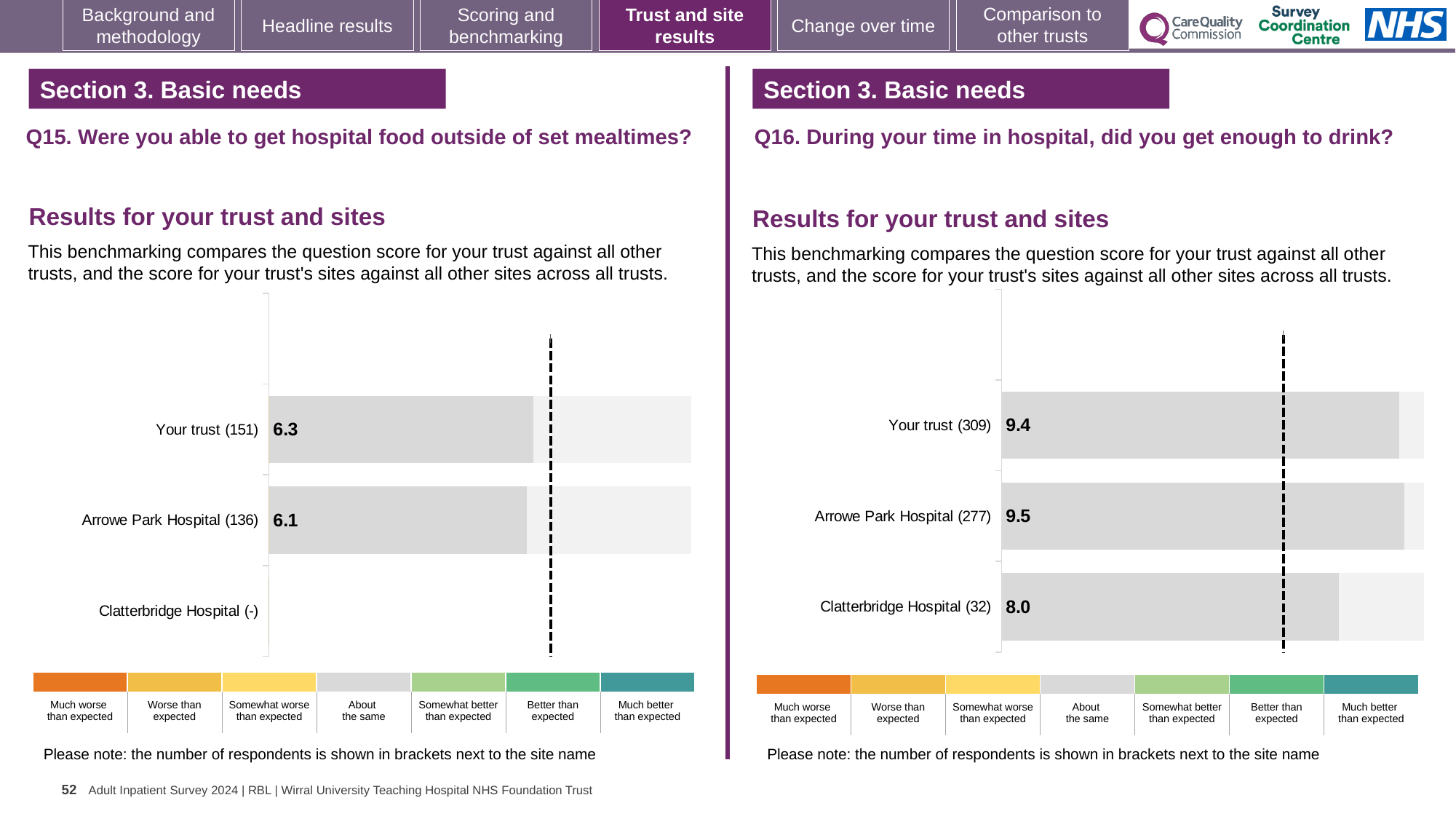
How many categories (trust and sites) are listed on the Q16 chart on the right? 3 In the Q15 chart on the left, what is the score for Your trust? 6.3 In the Q16 chart on the right, what is the score for Your trust? 9.4 In the Q15 chart on the left, how many respondents are shown in brackets for Arrowe Park Hospital? 136 In the Q15 chart on the left, what is the score for Arrowe Park Hospital? 6.1 What kind of chart is used for the Q15 results on the left? Bar chart In the Q16 chart on the right, what is the score for Clatterbridge Hospital? 8.0 In the Q15 chart on the left, which has the higher score, Your trust or Arrowe Park Hospital? Your trust In the Q15 chart on the left, what is the difference between the scores for Your trust and Arrowe Park Hospital? 0.2 In the Q16 chart on the right, which site or trust has the highest score? Arrowe Park Hospital In the Q16 chart on the right, which site or trust has the lowest score? Clatterbridge Hospital In the Q16 chart on the right, what is the difference between the scores for Arrowe Park Hospital and Clatterbridge Hospital? 1.5